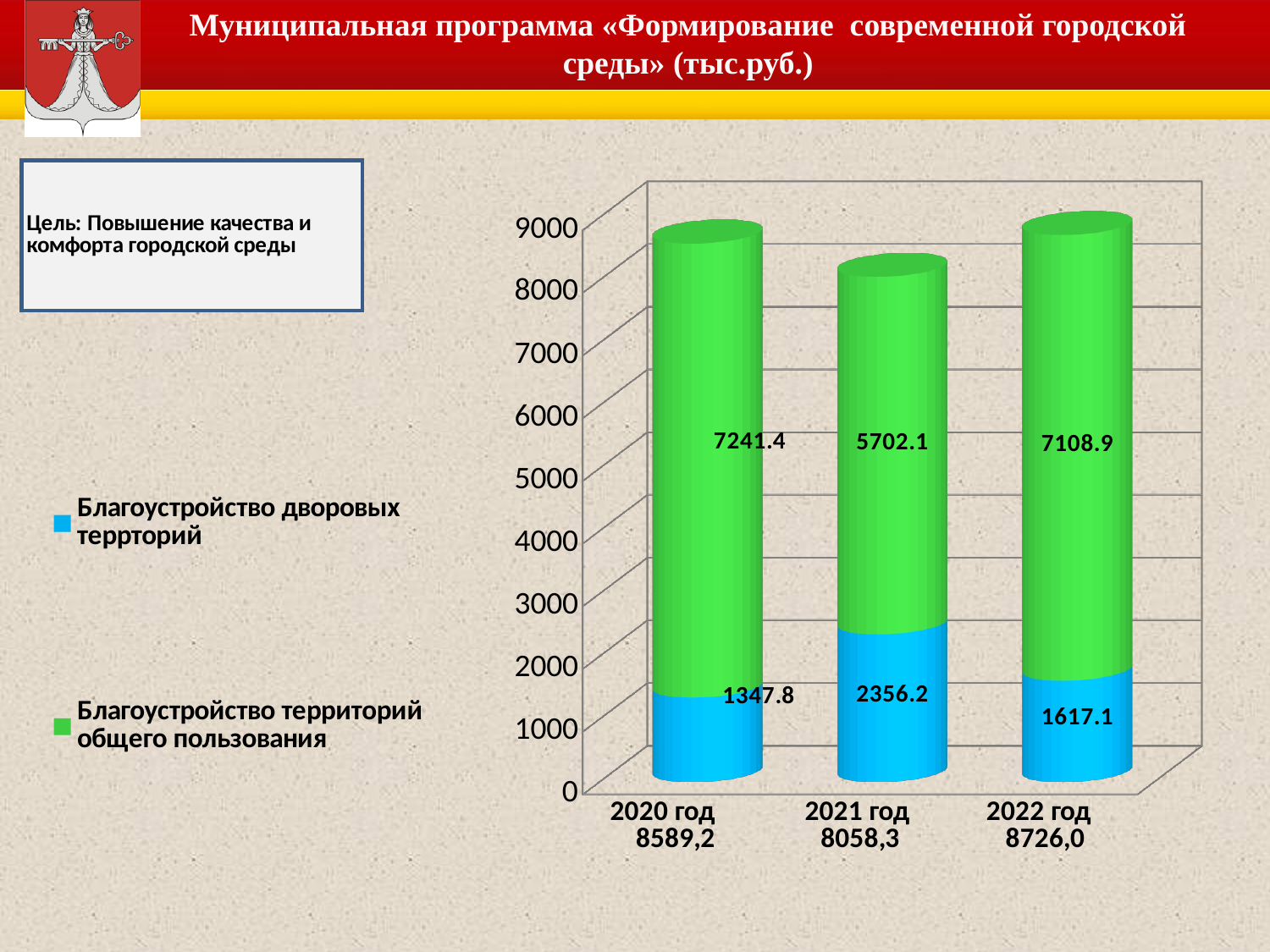
What is the value for Благоустройство дворовых терpторий in 2022 год? 1617.1 How many years are shown on the x axis? 3 Which is larger: the Благоустройство дворовых терpторий value for 2020 год or for 2022 год? 2022 год What kind of chart is shown on the slide? Stacked bar chart How many series does the legend list? 2 What is the total of the stacked bar for 2021 год? 8058,3 In which year is the value for Благоустройство дворовых терpторий highest? 2021 год In which year is the value for Благоустройство территорий общего пользования lowest? 2021 год What is the difference between the Благоустройство территорий общего пользования values for 2020 год and 2022 год? 132.5 Which colour represents Благоустройство территорий общего пользования in the chart? Green What is the value for Благоустройство территорий общего пользования in 2020 год? 7241.4 What is the value for Благоустройство дворовых терpторий in 2021 год? 2356.2